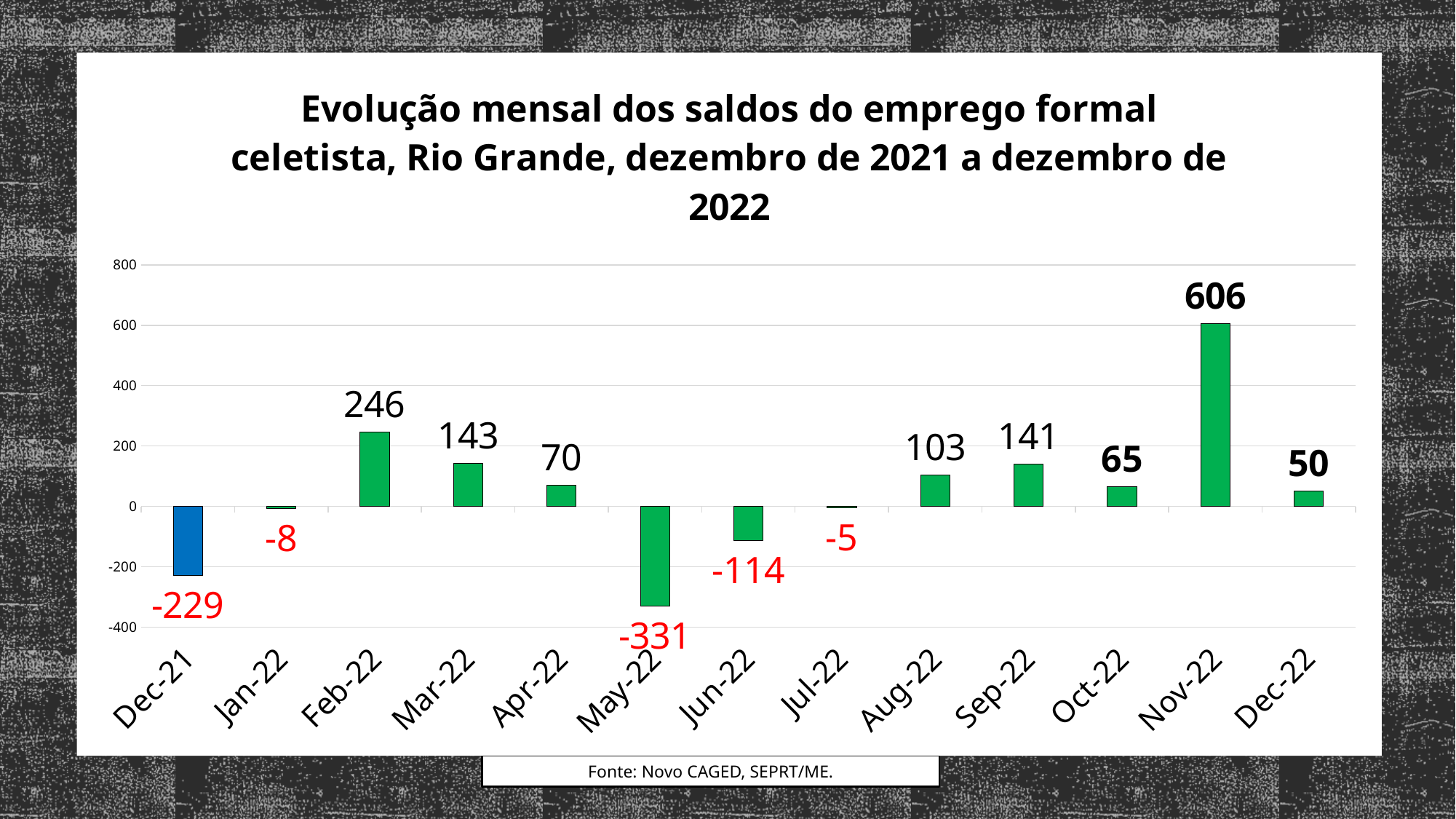
Which month has the highest value? Nov-22 What kind of chart is shown on the slide? bar chart What is the value for May-22? -331 What is the value for Nov-22? 606 What is the difference between the values for Feb-22 and Mar-22? 103 What is the source cited below the chart? Novo CAGED, SEPRT/ME. How many months are shown on the x axis? 13 What is the value for Dec-21? -229 What is the value for Aug-22? 103 Is the value for Nov-22 greater or less than 400? greater Which is larger, the value for Sep-22 or the value for Oct-22? Sep-22 Which month has the lowest value? May-22